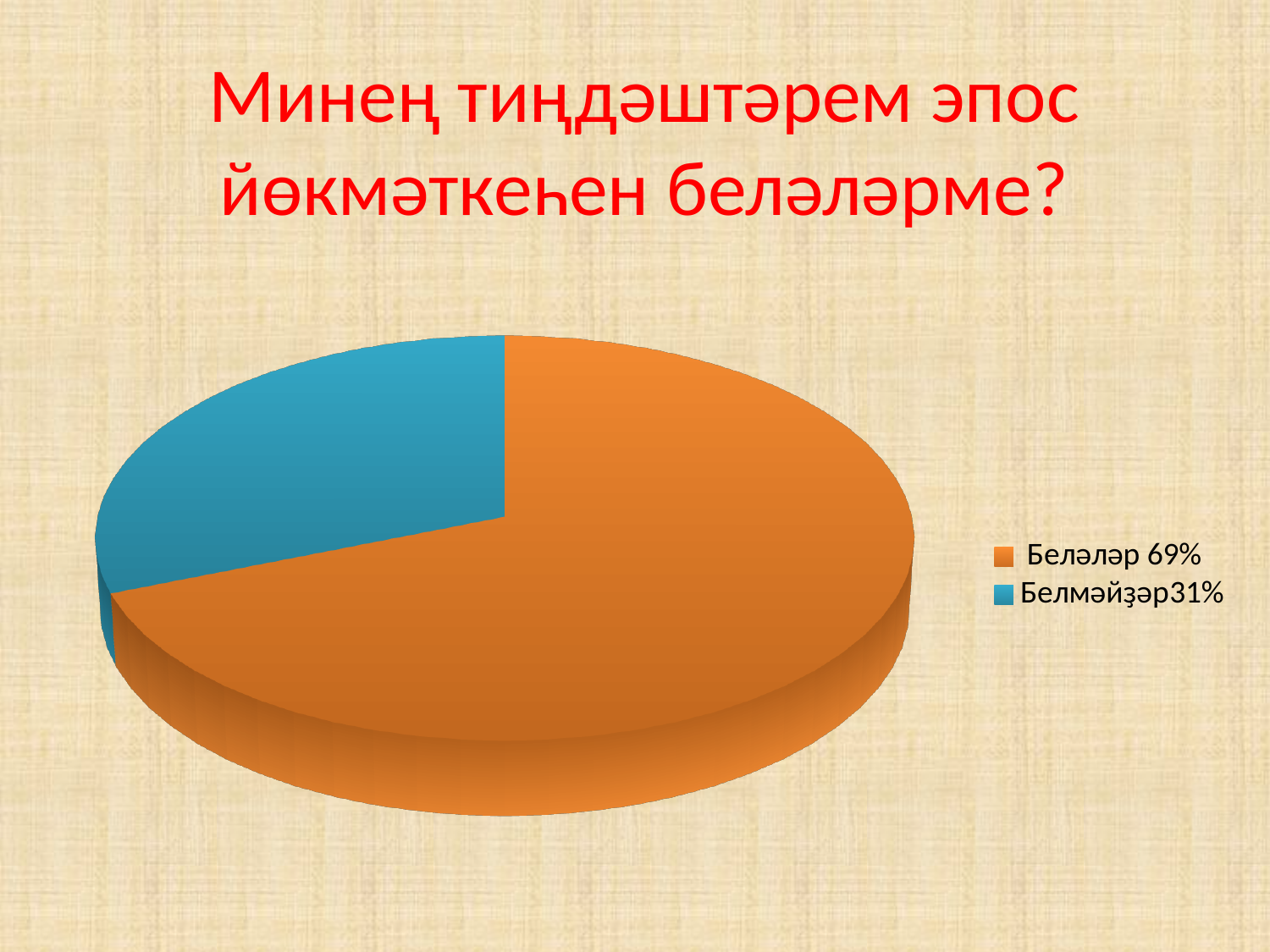
Which slice is the smallest in the pie chart? Белмәйҙәр What colour is the slice for "Белмәйҙәр"? blue What share of the pie does the slice "Белмәйҙәр" represent? 31% What kind of chart is shown on the slide? pie chart How many slices does the pie chart have? 2 How many entries does the legend list? 2 Is the share for "Беләләр" greater or less than 50%? greater Which is larger, the share for "Беләләр" or the share for "Белмәйҙәр"? Беләләр What share of the pie does the slice "Беләләр" represent? 69% Which slice is the largest in the pie chart? Беләләр What is the title of the slide above the pie chart? Минең тиңдәштәрем эпос йөкмәткеһен беләләрме? What is the difference in percentage points between the "Беләләр" and "Белмәйҙәр" slices? 38